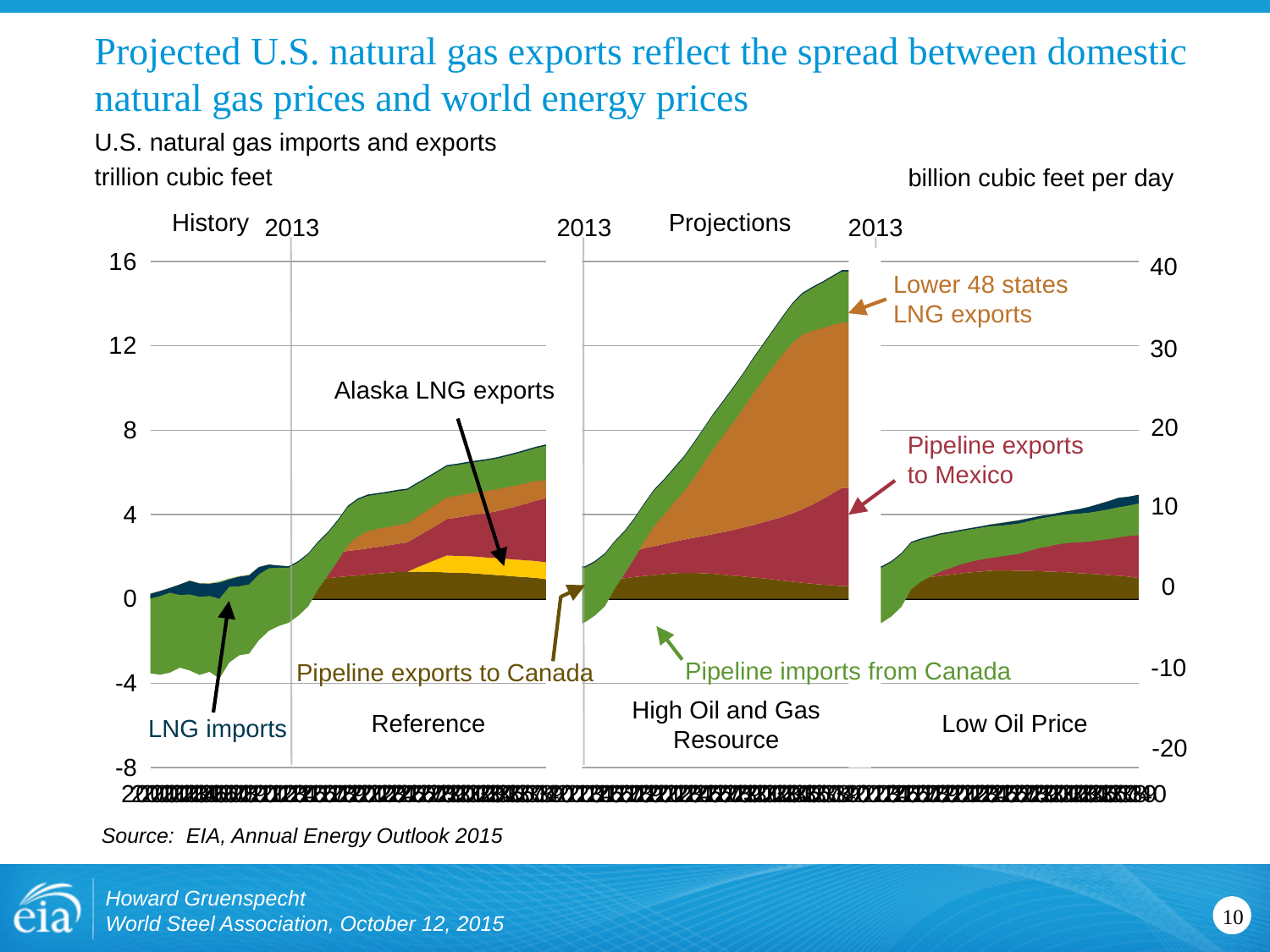
In the Low Oil Price panel, is the total at the top of the stacked exports at the end of the projection greater or less than 8 trillion cubic feet? less In the High Oil and Gas Resource panel, is the total at the top of the stacked exports at the end of the projection greater or less than 12 trillion cubic feet? greater What is the title of the chart? U.S. natural gas imports and exports In the Reference panel, is the total at the top of the stacked exports at the end of the projection greater or less than 8 trillion cubic feet? less What kind of chart is shown on the slide? stacked area chart What unit is shown on the left vertical axis of the chart? trillion cubic feet Is the end-of-projection total in the High Oil and Gas Resource panel larger or smaller than in the Reference panel? larger Which scenario panel shows the lowest total exports at the end of the projection period? Low Oil Price In the Reference panel, do total exports rise or fall over the projection period after 2013? rise Which scenario panel shows the highest total exports at the end of the projection period? High Oil and Gas Resource Which export category appears only in the Reference panel, shown in yellow? Alaska LNG exports How many scenario panels are shown in the projections part of the chart? 3